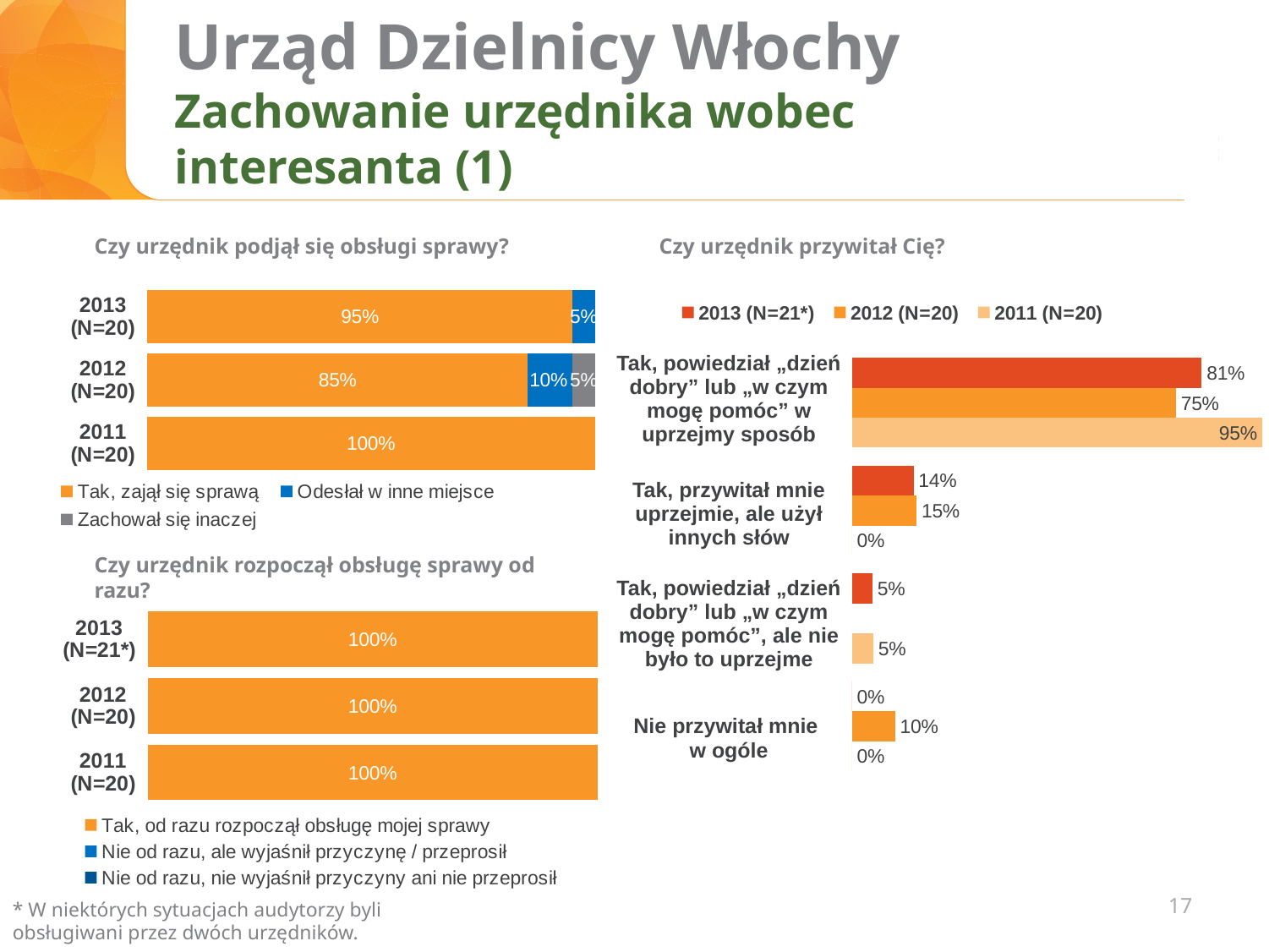
In the chart 'Czy urzędnik podjął się obsługi sprawy?', which year has the highest share of 'Tak, zajął się sprawą'? 2011 (N=20) In the chart 'Czy urzędnik przywitał Cię?', which is larger for 'Tak, przywitał mnie uprzejmie, ale użył innych słów': 2013 (N=21*) or 2012 (N=20)? 2012 (N=20) In the chart 'Czy urzędnik podjął się obsługi sprawy?', what is the difference between the 'Tak, zajął się sprawą' values for 2013 and 2012? 10% In the chart 'Czy urzędnik rozpoczął obsługę sprawy od razu?', what is the value of 'Tak, od razu rozpoczął obsługę mojej sprawy' for 2013 (N=21*)? 100% In the chart 'Czy urzędnik podjął się obsługi sprawy?', what is the value of 'Odesłał w inne miejsce' for 2012 (N=20)? 10% In the chart 'Czy urzędnik podjął się obsługi sprawy?', what percentage for 2013 (N=20) is 'Tak, zajął się sprawą'? 95% In the chart 'Czy urzędnik przywitał Cię?', what is the 2011 (N=20) value for 'Tak, powiedział „dzień dobry” lub „w czym mogę pomóc” w uprzejmy sposób'? 95% How many categories are shown in the chart 'Czy urzędnik przywitał Cię?'? 4 What type of chart is 'Czy urzędnik rozpoczął obsługę sprawy od razu?'? Stacked bar chart How many series does the legend of the chart 'Czy urzędnik podjął się obsługi sprawy?' list? 3 In the chart 'Czy urzędnik przywitał Cię?', what is the difference between the 2011 and 2013 values for 'Tak, powiedział „dzień dobry” lub „w czym mogę pomóc” w uprzejmy sposób'? 14% In the chart 'Czy urzędnik przywitał Cię?', what is the 2012 (N=20) value for 'Nie przywitał mnie w ogóle'? 10%